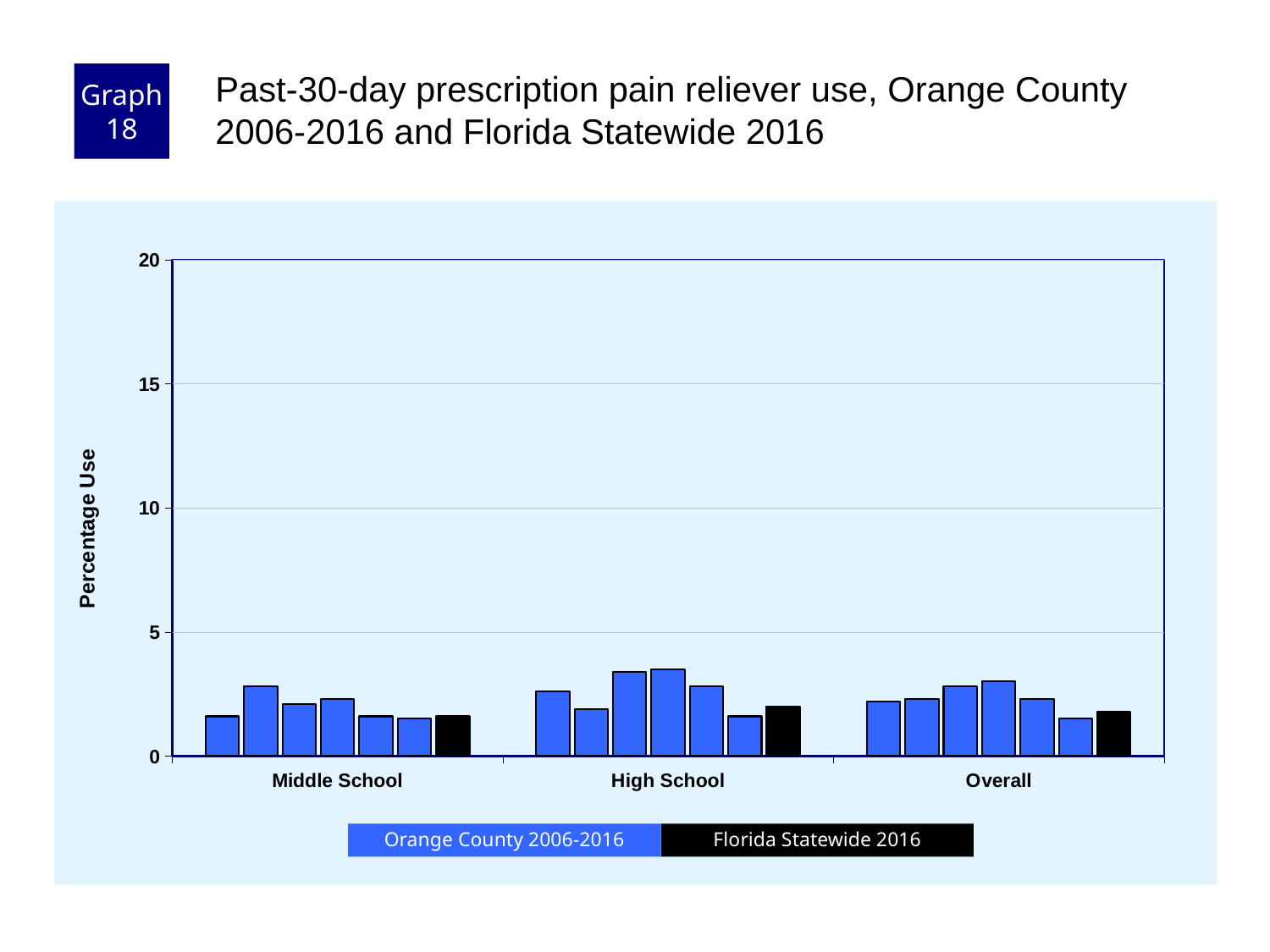
Is the highest Orange County bar for High School greater or less than 5? less What kind of chart is shown on the slide? bar chart What is the label on the y axis? Percentage Use How many bars are plotted for the Middle School category? 7 What is the highest value shown on the y axis? 20 Which category contains the tallest bar on the chart? High School How many series does the legend list? 2 Is the Florida Statewide 2016 value for Overall greater or less than 5? less How many categories are shown along the x axis? 3 Are any of the bars on the chart greater than 10? No What are the two series named in the legend? Orange County 2006-2016 and Florida Statewide 2016